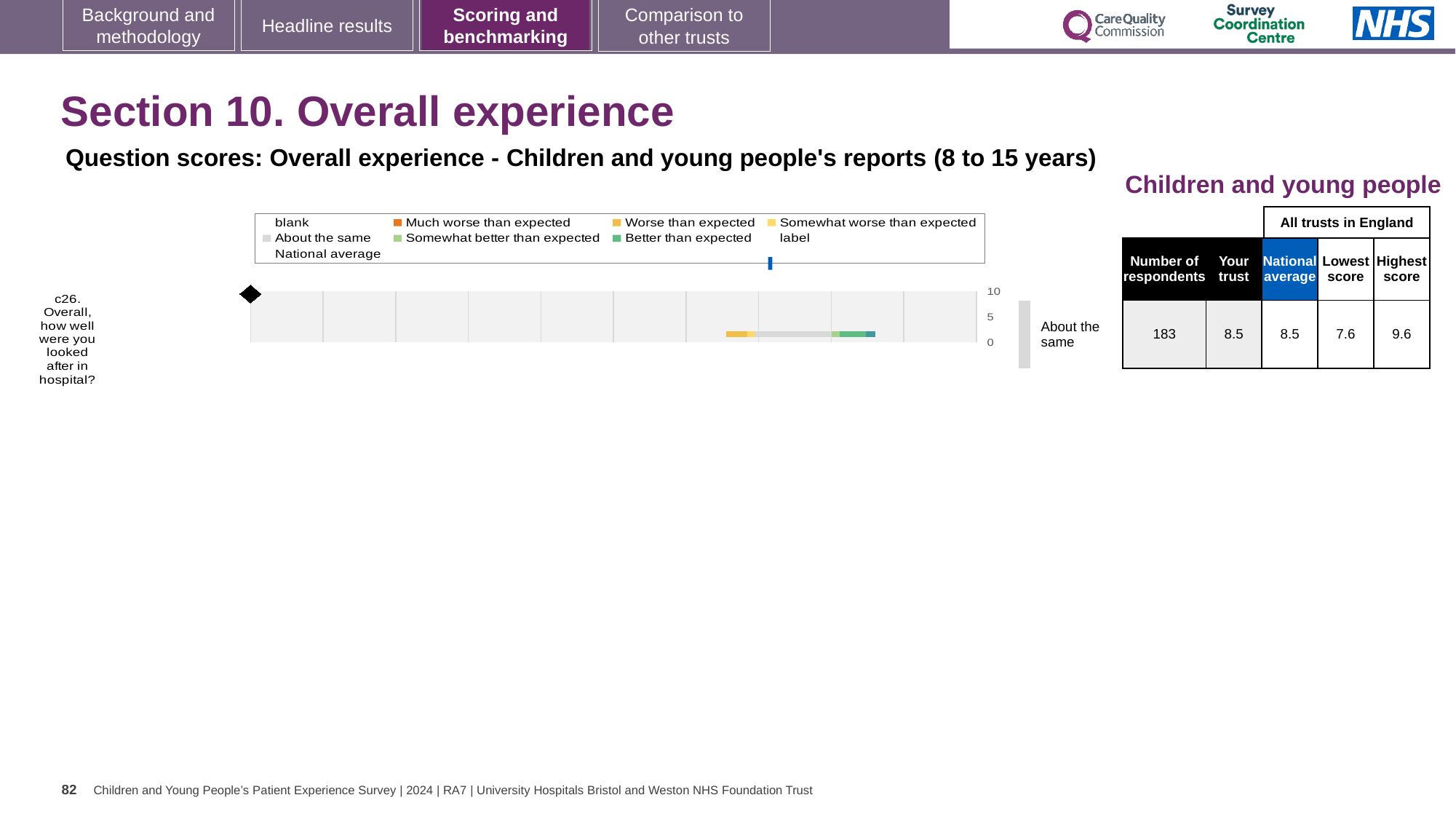
What is the highest value shown on the chart's numeric axis? 10 What rating label is shown to the right of the bar for question c26? About the same How many survey questions are plotted in the chart on this slide? 1 What kind of chart is shown for question c26 on this slide? bar chart In the table beside the chart, what is the lowest score among all trusts in England for question c26? 7.6 In the table beside the chart, what is the highest score among all trusts in England for question c26? 9.6 In the table beside the chart, what is the national average score for question c26? 8.5 In the table beside the chart, what is the 'Your trust' score for question c26? 8.5 What is the difference between the highest score and the lowest score for question c26 in the table beside the chart? 2.0 Which question is plotted in the chart on this slide? c26. Overall, how well were you looked after in hospital? In the table beside the chart, what is the number of respondents for question c26? 183 Is the 'Your trust' score for question c26 larger than, smaller than, or equal to the national average? equal